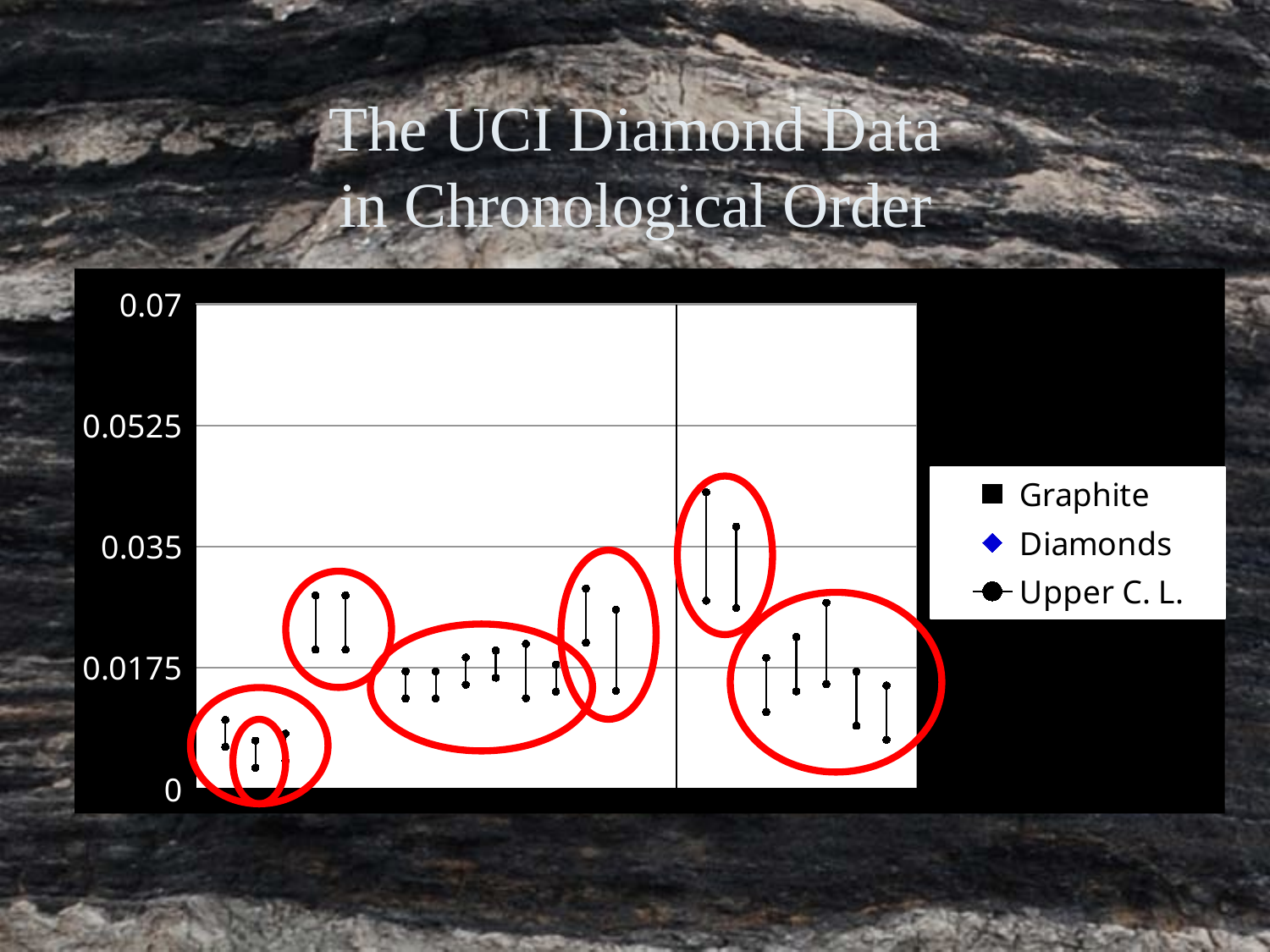
Is the lowest plotted value on the chart greater or less than 0.0175? less What is the title shown above the chart? The UCI Diamond Data in Chronological Order How many red ovals are drawn around groups of points on the chart? 7 Is the highest plotted value on the chart greater or less than 0.035? greater How many tick labels are shown on the y-axis? 5 How many series does the legend list? 3 What are the three entries in the chart legend? Graphite, Diamonds, Upper C. L. Are the highest plotted values located to the left or to the right of the vertical line in the middle of the chart? right What is the highest value labelled on the y-axis? 0.07 Is the highest plotted value on the chart greater or less than 0.0525? less What y-axis tick label appears between 0.035 and 0.07? 0.0525 How many vertical line segments (data points) are plotted on the chart? 20